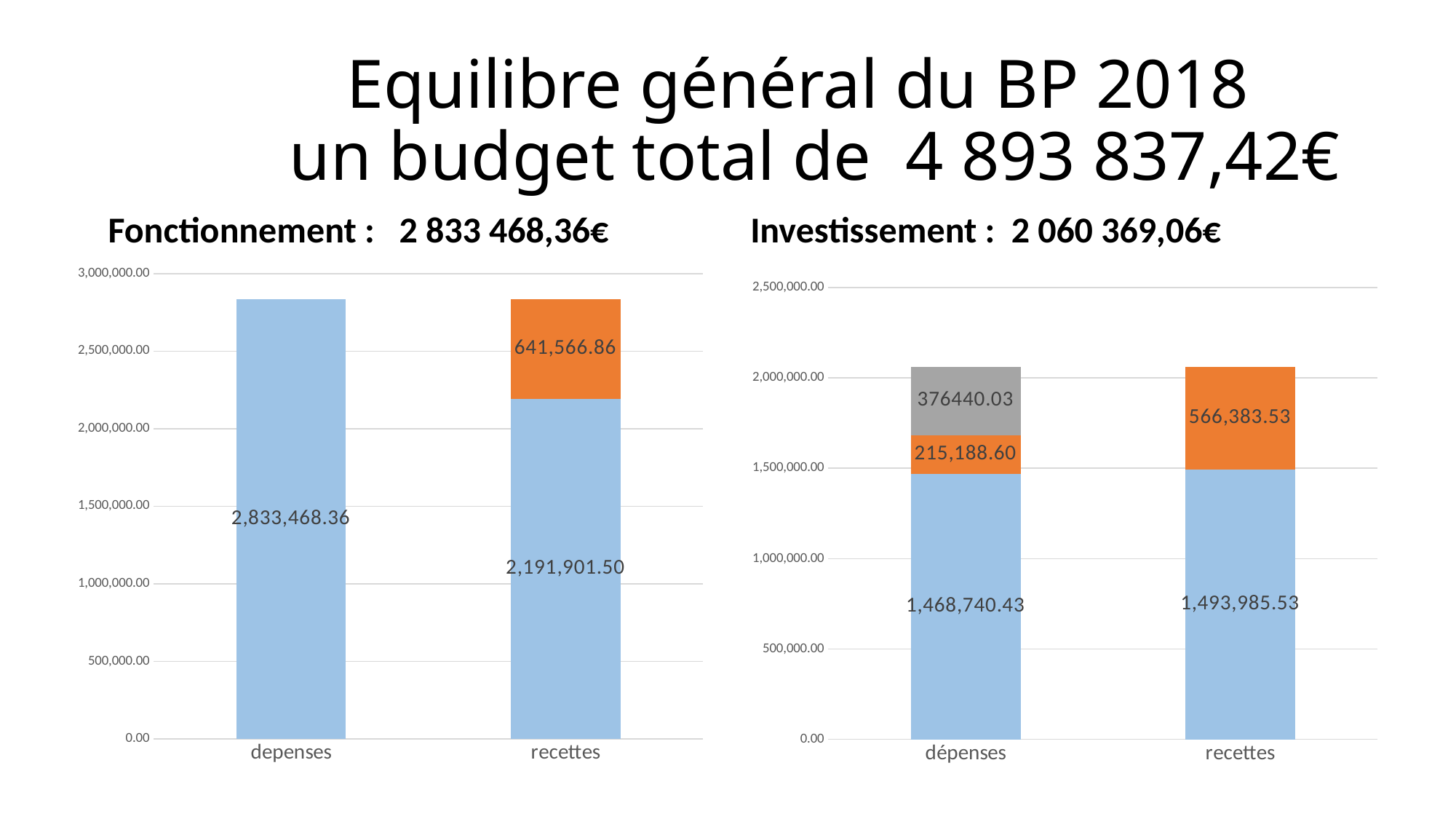
In the Investissement chart, what is the total of the stacked dépenses bar? 2,060,369.06 In the Fonctionnement chart, what is the value of the blue segment of the recettes bar? 2,191,901.50 What kind of chart is the Fonctionnement chart? Stacked bar chart In the Investissement chart, what is the value of the gray segment of the dépenses bar? 376440.03 In the Fonctionnement chart, what is the total of the stacked recettes bar? 2,833,468.36 In the Investissement chart, what is the difference between the orange segments of the recettes bar and the dépenses bar? 351,194.93 How many categories are shown on the x axis of the Investissement chart? 2 In the Investissement chart, what is the value of the blue segment of the recettes bar? 1,493,985.53 In the Fonctionnement chart, what is the value of the single segment of the depenses bar? 2,833,468.36 In the Fonctionnement chart, what is the value of the orange segment of the recettes bar? 641,566.86 In the Investissement chart, is the total of the recettes bar greater or less than 2,000,000.00? greater In the Investissement chart, what is the value of the orange segment of the dépenses bar? 215,188.60